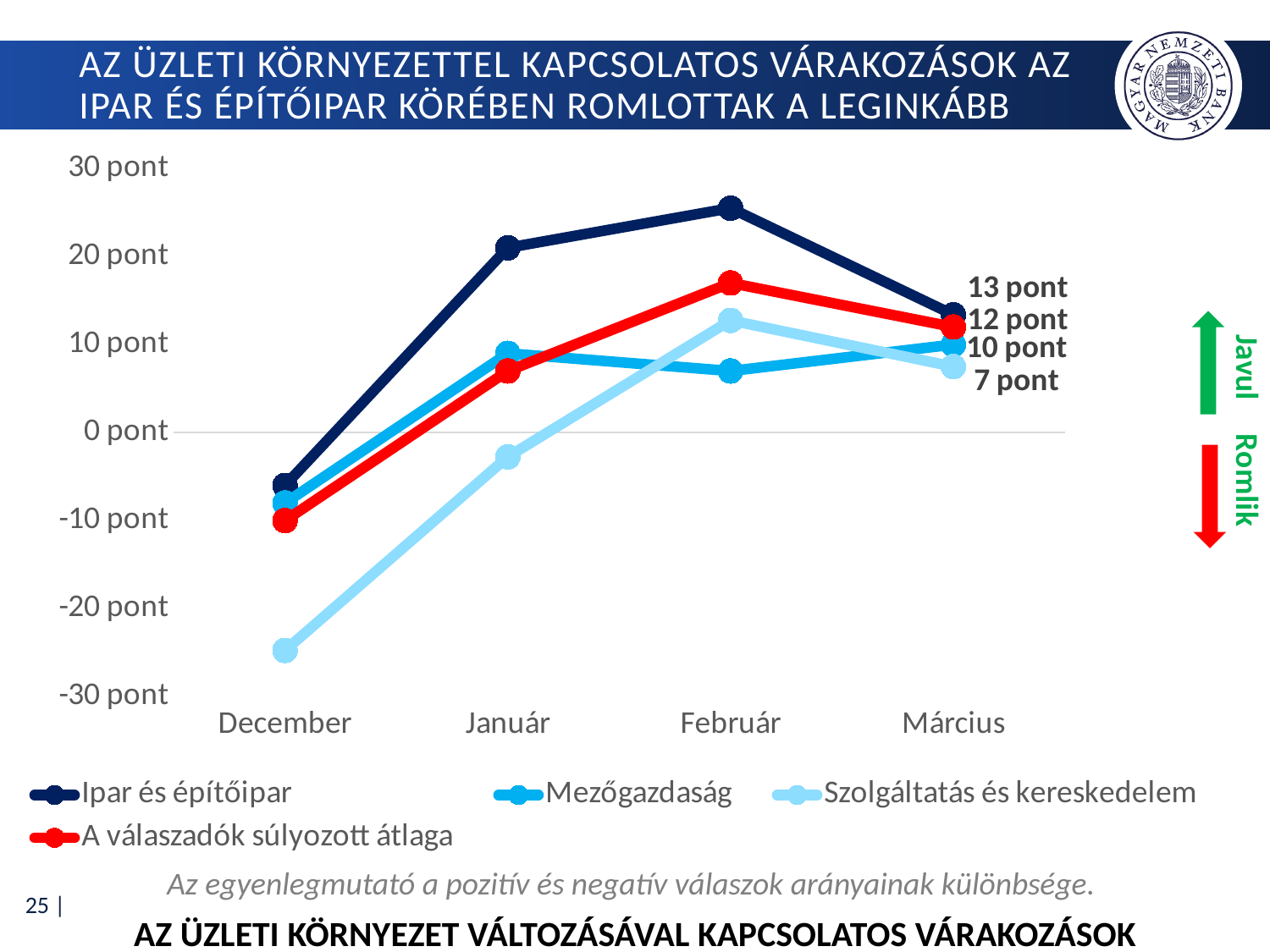
What is the value for Ipar és építőipar in Március? 13 pont What is the value for Mezőgazdaság in Március? 10 pont What is the value for A válaszadók súlyozott átlaga in Március? 12 pont What is the difference between Ipar és építőipar and Szolgáltatás és kereskedelem in Március? 6 pont What is the value for Szolgáltatás és kereskedelem in Március? 7 pont Is the value for Szolgáltatás és kereskedelem in December greater or less than -20 pont? less What kind of chart is shown on the slide? line chart How many months are shown on the x axis? 4 How many series does the legend list? 4 Is the value for Ipar és építőipar in Február greater or less than 20 pont? greater Which series has the lowest value in Március? Szolgáltatás és kereskedelem Does the Ipar és építőipar line rise or fall from Február to Március? fall